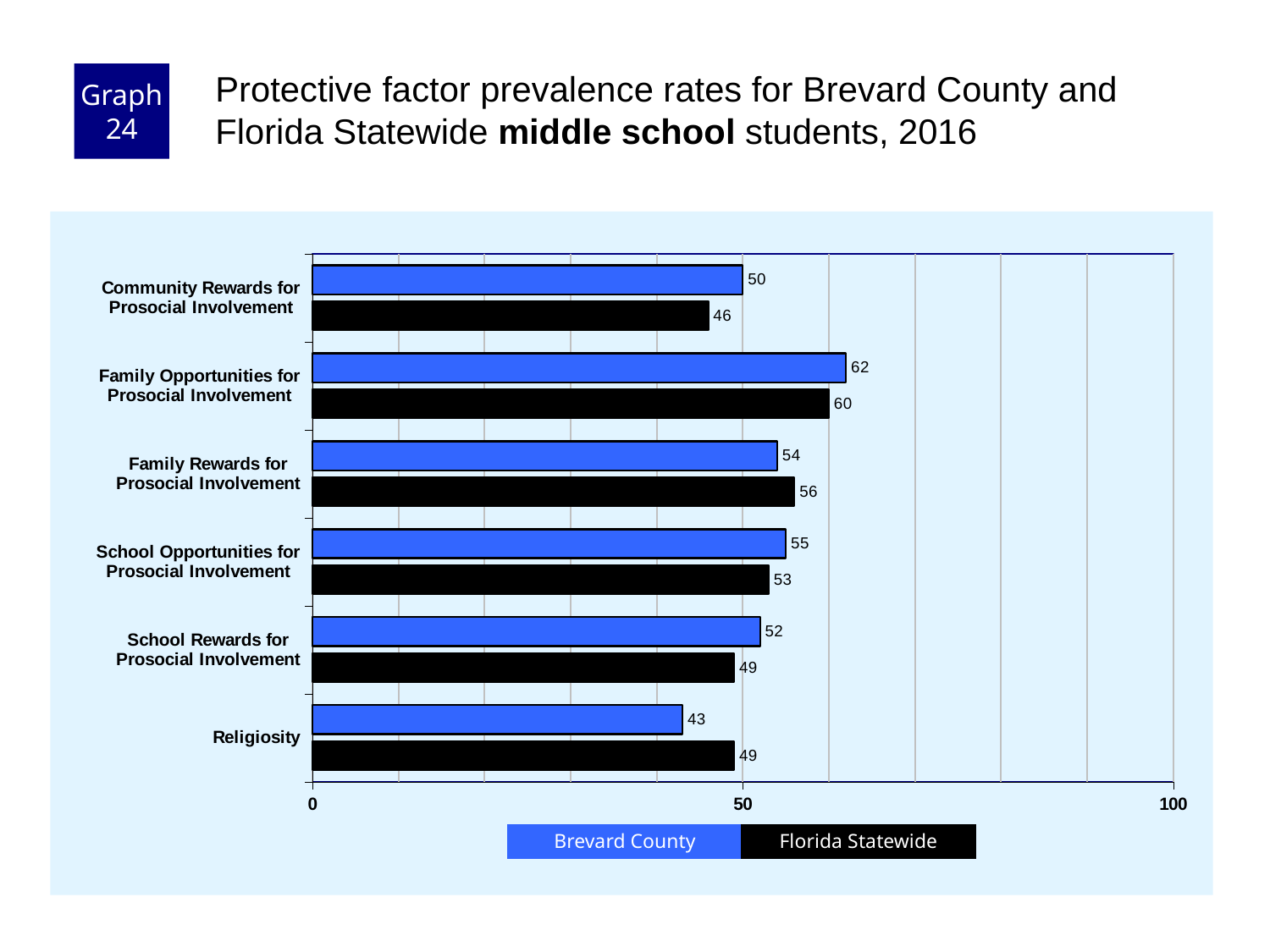
Is the Brevard County value for Religiosity greater or less than 50? less Which is larger for Family Rewards for Prosocial Involvement, the Brevard County value or the Florida Statewide value? Florida Statewide How many series does the legend list? 2 Which category has the lowest Brevard County value? Religiosity Which colour represents Florida Statewide in the chart? black How many categories are shown on the chart? 6 What is the Florida Statewide value for Community Rewards for Prosocial Involvement? 46 What is the Brevard County value for Family Opportunities for Prosocial Involvement? 62 What is the difference between the Brevard County and Florida Statewide values for Community Rewards for Prosocial Involvement? 4 What kind of chart is shown on the slide? bar chart What is the Florida Statewide value for Religiosity? 49 Which category has the highest Brevard County value? Family Opportunities for Prosocial Involvement